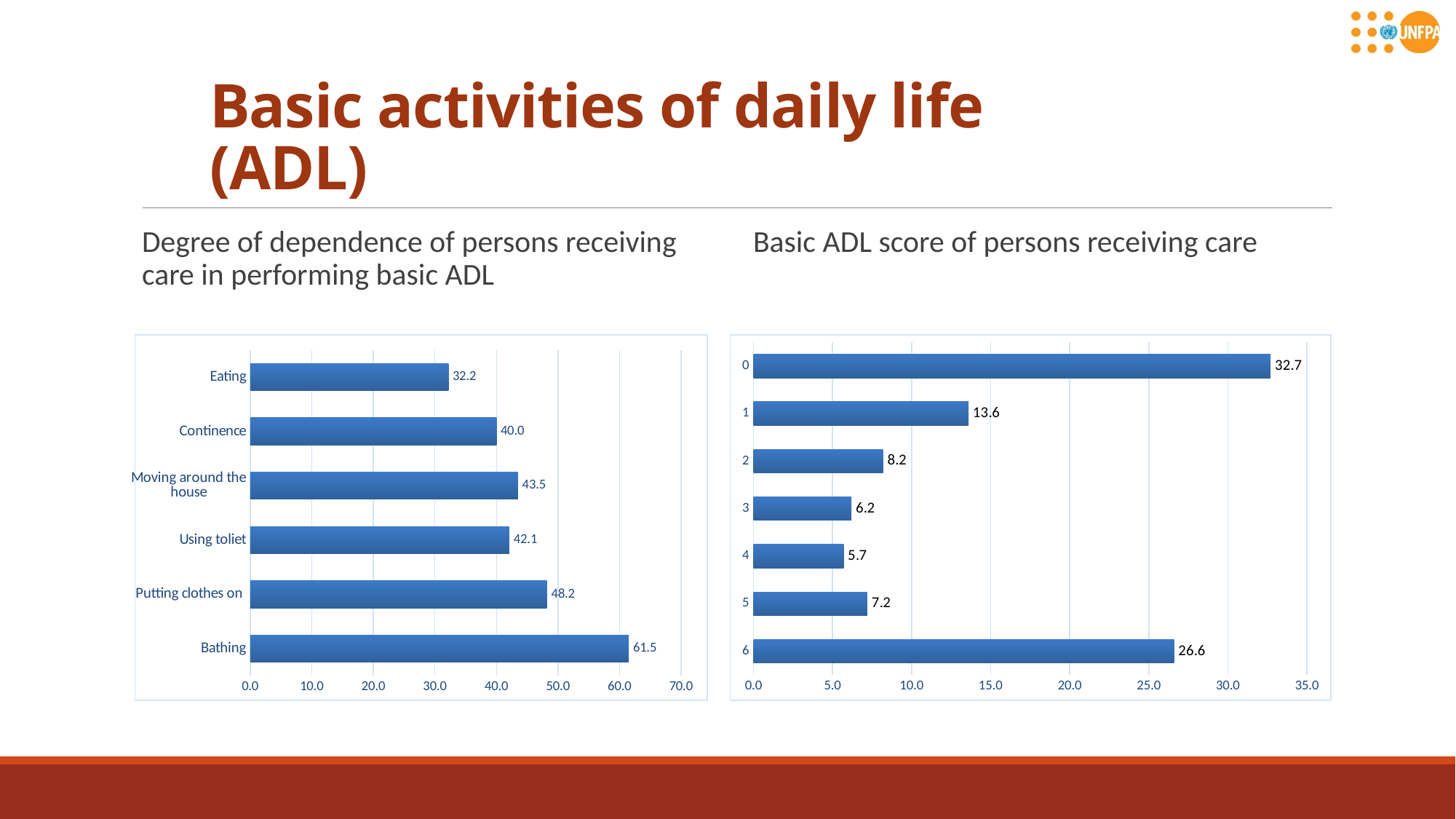
What type of chart is the right chart (Basic ADL score of persons receiving care)? Bar chart In the left chart (Degree of dependence in performing basic ADL), what is the value for Continence? 40.0 In the right chart (Basic ADL score of persons receiving care), what is the value for score 4? 5.7 In the right chart (Basic ADL score of persons receiving care), which is larger, the value for score 1 or the value for score 6? score 6 In the left chart (Degree of dependence in performing basic ADL), what is the difference between the values for Bathing and Eating? 29.3 In the right chart (Basic ADL score of persons receiving care), what is the difference between the values for score 0 and score 6? 6.1 In the left chart (Degree of dependence in performing basic ADL), what is the value for Bathing? 61.5 In the left chart (Degree of dependence in performing basic ADL), which activity has the lowest value? Eating In the right chart (Basic ADL score of persons receiving care), which score has the lowest value? 4 In the left chart (Degree of dependence in performing basic ADL), how many activities are shown? 6 In the right chart (Basic ADL score of persons receiving care), what is the value for score 0? 32.7 In the left chart (Degree of dependence in performing basic ADL), which activity has the highest value? Bathing